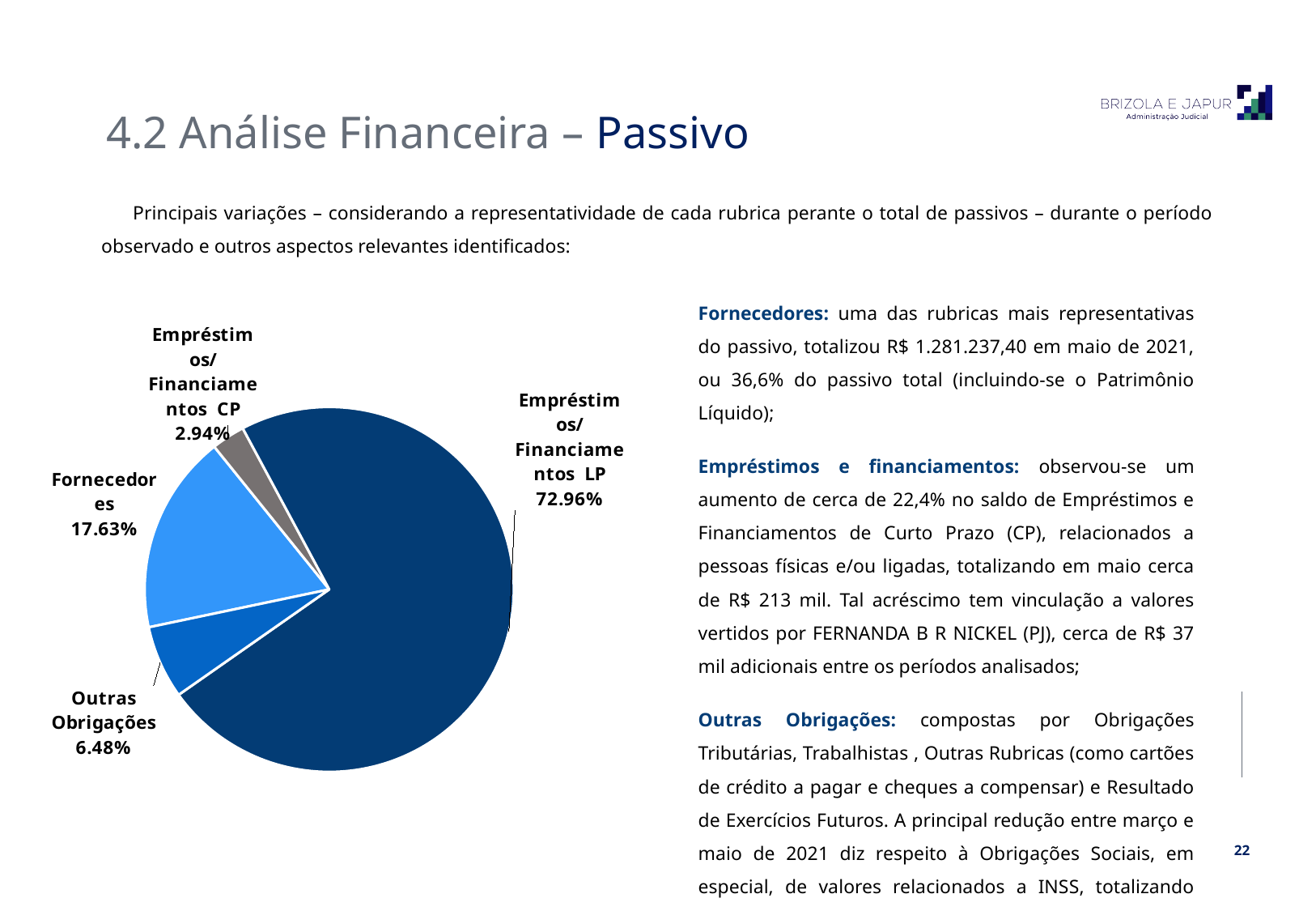
How many slices does the pie chart have? 4 Which slice of the pie chart is the largest? Empréstimos/Financiamentos LP Which slice of the pie chart is the smallest? Empréstimos/Financiamentos CP What is the value shown for Fornecedores in the pie chart? 17.63% What is the difference in percentage points between Empréstimos/Financiamentos LP and Fornecedores? 55.33 What is the value shown for Outras Obrigações in the pie chart? 6.48% What share of the pie does Empréstimos/Financiamentos LP represent? 72.96% What is the difference in percentage points between Fornecedores and Outras Obrigações? 11.15 Which is larger in the pie chart, Fornecedores or Outras Obrigações? Fornecedores What kind of chart is shown on the slide? Pie chart What is the value shown for Empréstimos/Financiamentos CP in the pie chart? 2.94% Which slice of the pie chart is coloured grey? Empréstimos/Financiamentos CP